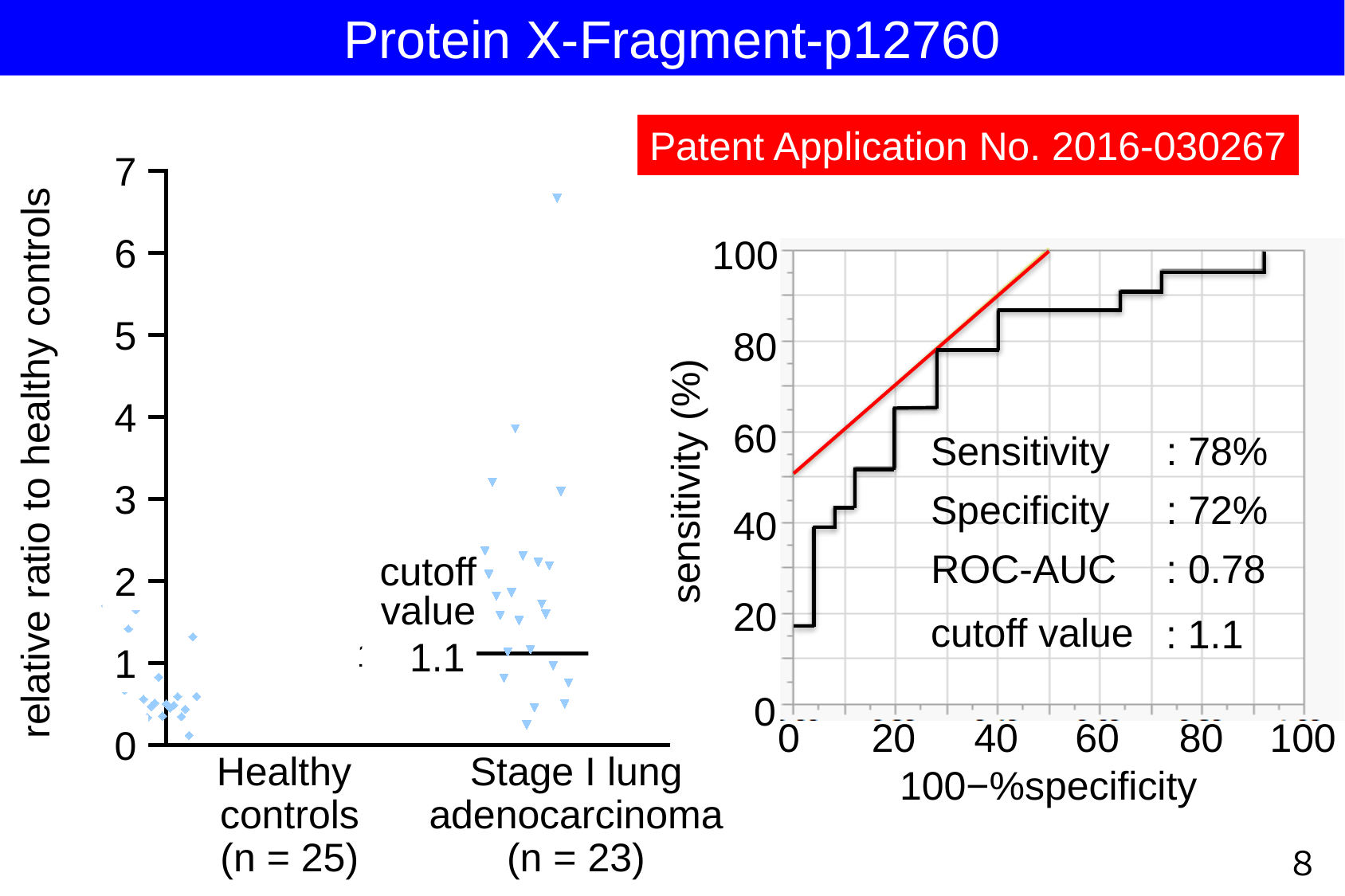
On the left chart, is the highest point in the Stage I lung adenocarcinoma group greater or less than 6? greater On the right chart, what specificity is reported? 72% On the left chart, how many Stage I lung adenocarcinoma samples are indicated (n)? 23 On the left chart, which group contains the highest plotted point? Stage I lung adenocarcinoma On the left chart, what is the label of the y axis? relative ratio to healthy controls On the right chart, what sensitivity is reported? 78% On the right chart, what is the highest tick value on the sensitivity axis? 100 On the left chart, how many groups are plotted along the x axis? 2 On the right chart, what is the ROC-AUC value? 0.78 On the left chart, what is the cutoff value shown? 1.1 On the left chart, how many healthy controls are indicated (n)? 25 On the right chart, what is the label of the x axis? 100−%specificity